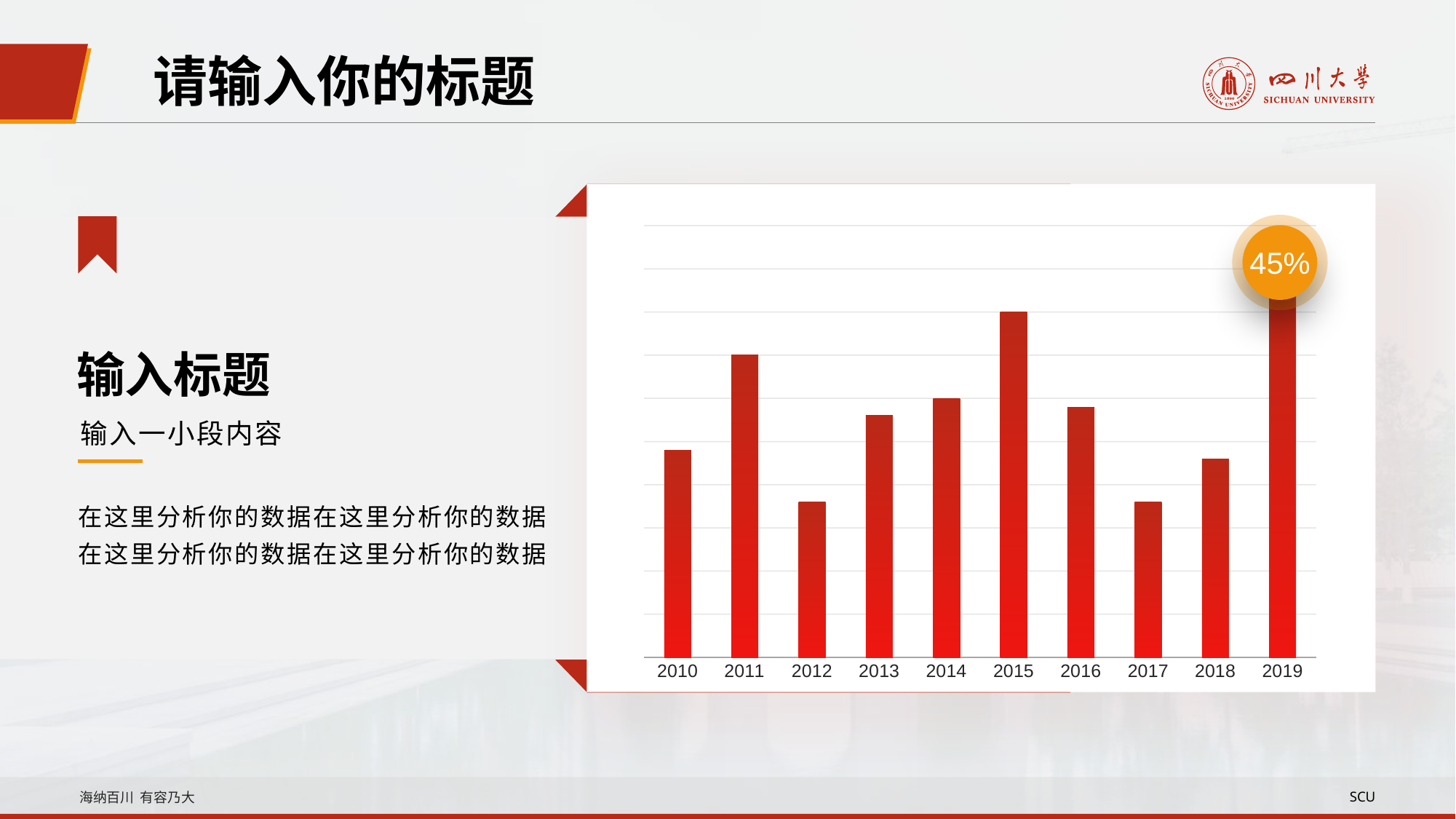
How many years are shown on the x axis of the chart? 10 Which bar is taller, 2018 or 2017? 2018 Which bar is taller, 2011 or 2014? 2011 Which bar is taller, 2015 or 2011? 2015 Which year has the tallest bar in the chart? 2019 What percentage is shown in the circular callout above the 2019 bar? 45% What is the first year shown on the x axis? 2010 Do the bars rise or fall from 2015 to 2017? fall Do the bars rise or fall from 2012 to 2014? rise What kind of chart is shown on the slide? bar chart